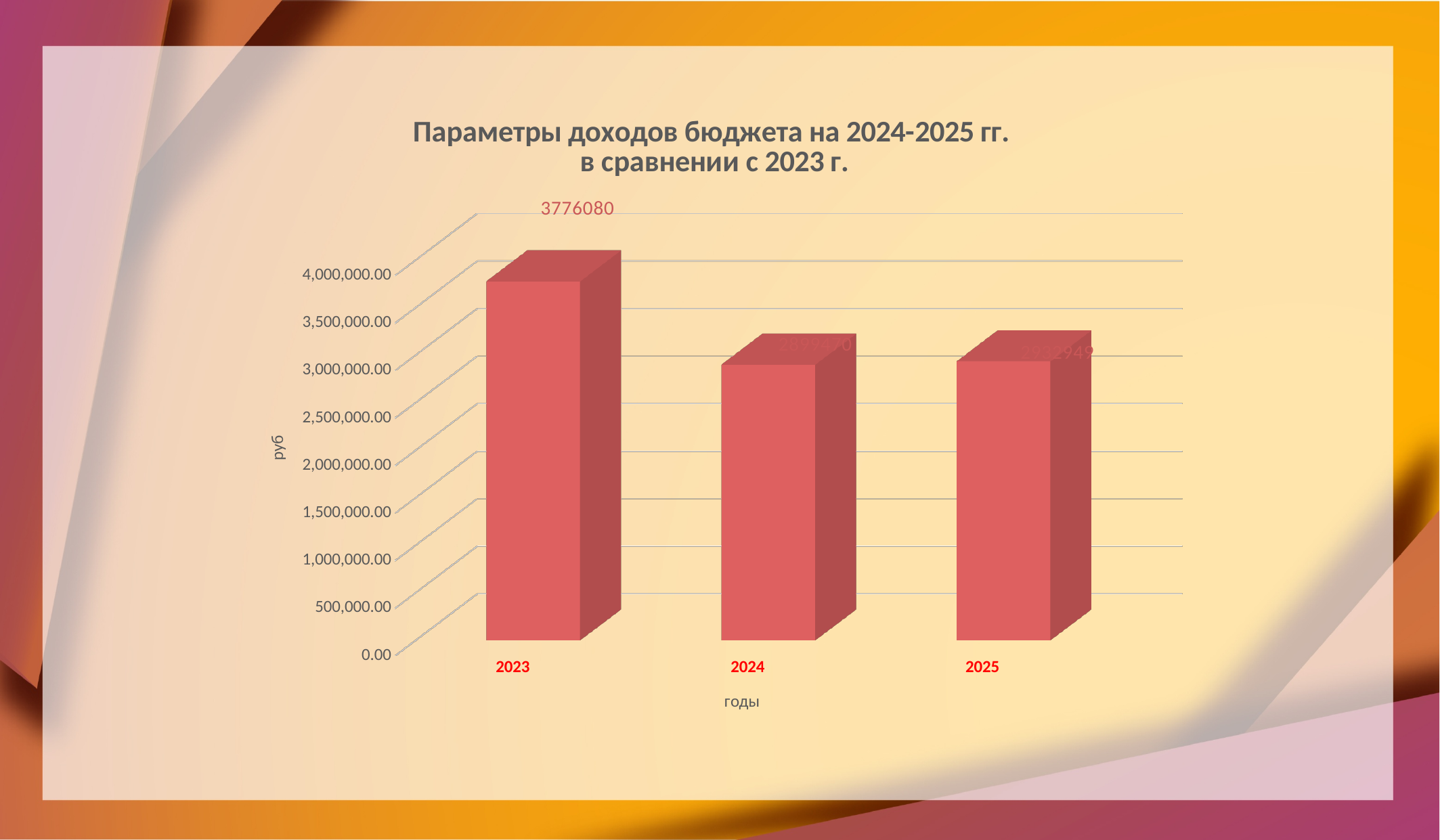
Is the value for 2023 greater or less than 3,500,000.00? greater What is the value for 2023? 3776080 What is the label of the vertical axis? руб What kind of chart is shown on the slide? bar chart Which is larger, the value for 2023 or the value for 2024? 2023 Is the value for 2025 greater or less than 2,500,000.00? greater Which is larger, the value for 2023 or the value for 2025? 2023 Is the value for 2024 greater or less than 3,500,000.00? less Does the value rise or fall from 2023 to 2024? fall Which year has the highest value? 2023 What is the label of the horizontal axis? годы How many years are shown on the x axis? 3